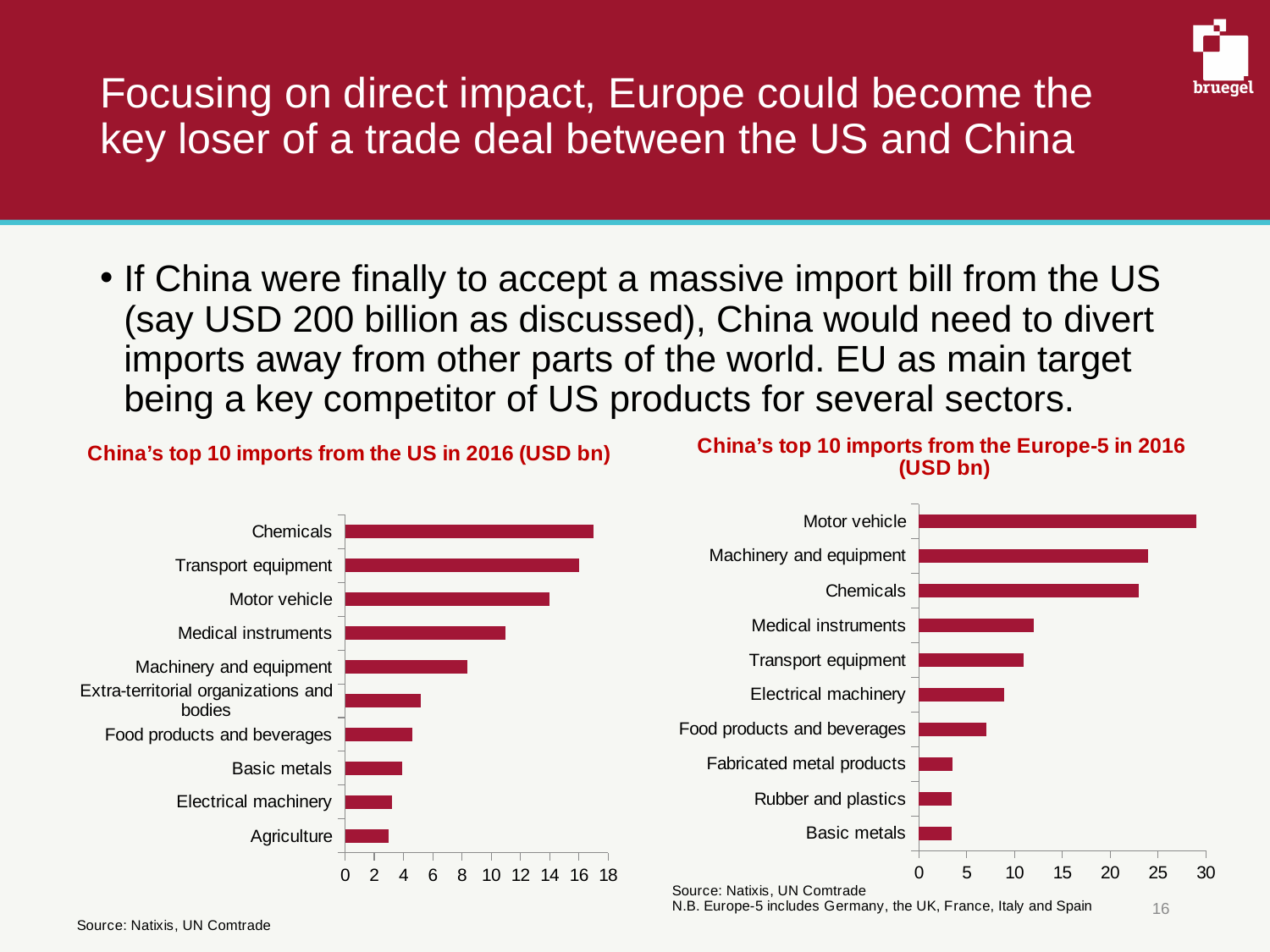
What kind of chart is the chart titled "China's top 10 imports from the US in 2016 (USD bn)"? Bar chart What is the title of the chart on the right side of the slide? China's top 10 imports from the Europe-5 in 2016 (USD bn) In the chart titled "China's top 10 imports from the Europe-5 in 2016 (USD bn)", which is larger: Medical instruments or Electrical machinery? Medical instruments In the chart titled "China's top 10 imports from the US in 2016 (USD bn)", is the value for Machinery and equipment greater or less than 10? less In the chart titled "China's top 10 imports from the Europe-5 in 2016 (USD bn)", is the value for Food products and beverages greater or less than 10? less In the chart titled "China's top 10 imports from the US in 2016 (USD bn)", which category has the highest value? Chemicals In the chart titled "China's top 10 imports from the Europe-5 in 2016 (USD bn)", which category has the highest value? Motor vehicle In the chart titled "China's top 10 imports from the Europe-5 in 2016 (USD bn)", is the value for Motor vehicle greater or less than 25? greater In the chart titled "China's top 10 imports from the US in 2016 (USD bn)", which is larger: Transport equipment or Medical instruments? Transport equipment How many categories are shown in the chart titled "China's top 10 imports from the Europe-5 in 2016 (USD bn)"? 10